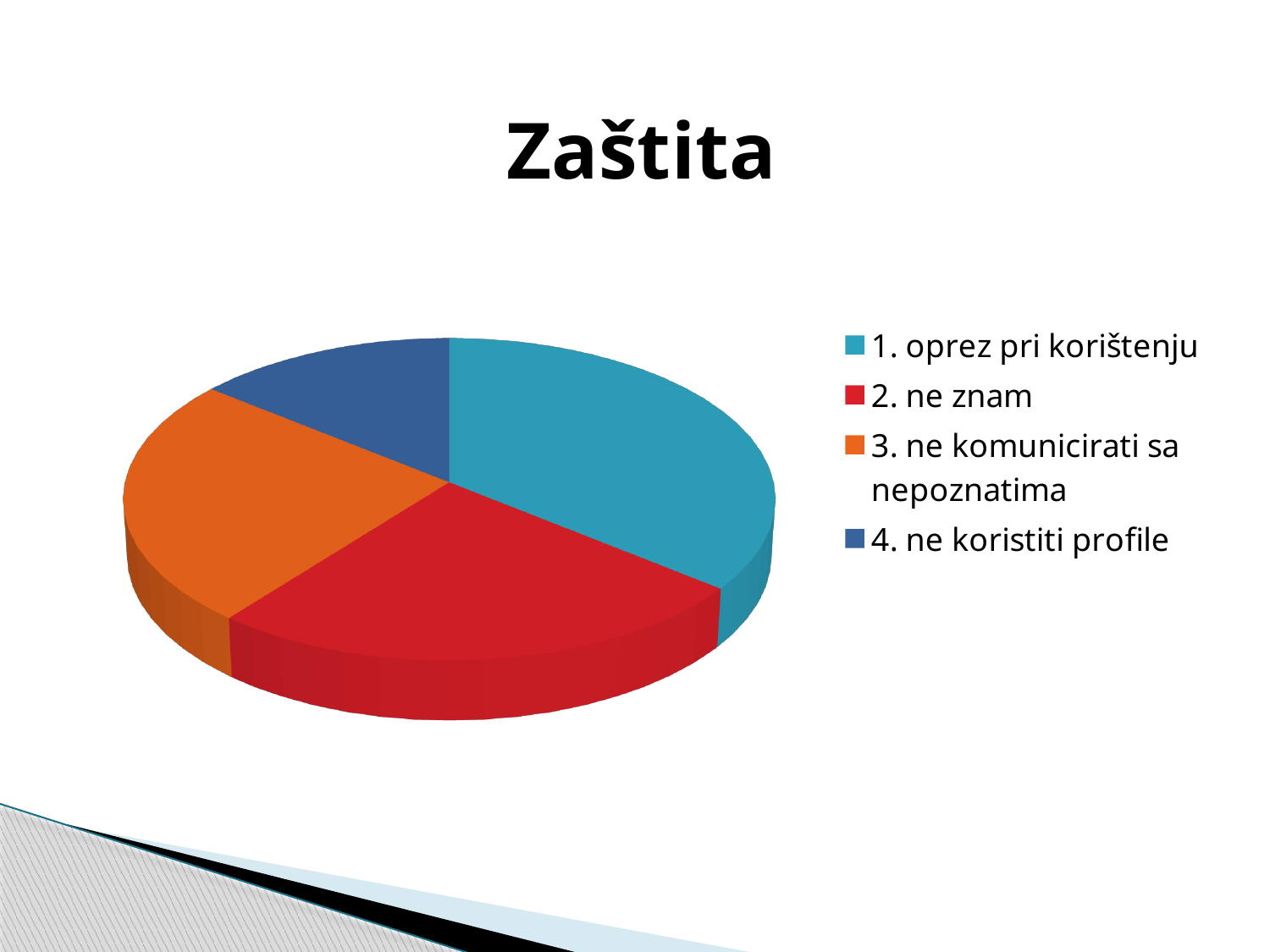
Which slice is larger: "2. ne znam" or "4. ne koristiti profile"? 2. ne znam Which category has the smallest slice of the pie? 4. ne koristiti profile Which slice is larger: "1. oprez pri korištenju" or "4. ne koristiti profile"? 1. oprez pri korištenju How many slices does the pie chart have? 4 Which slice is larger: "3. ne komunicirati sa nepoznatima" or "4. ne koristiti profile"? 3. ne komunicirati sa nepoznatima What is the title of the slide containing the pie chart? Zaštita Which colour represents "2. ne znam" in the pie chart? red What kind of chart is shown on the slide? pie chart